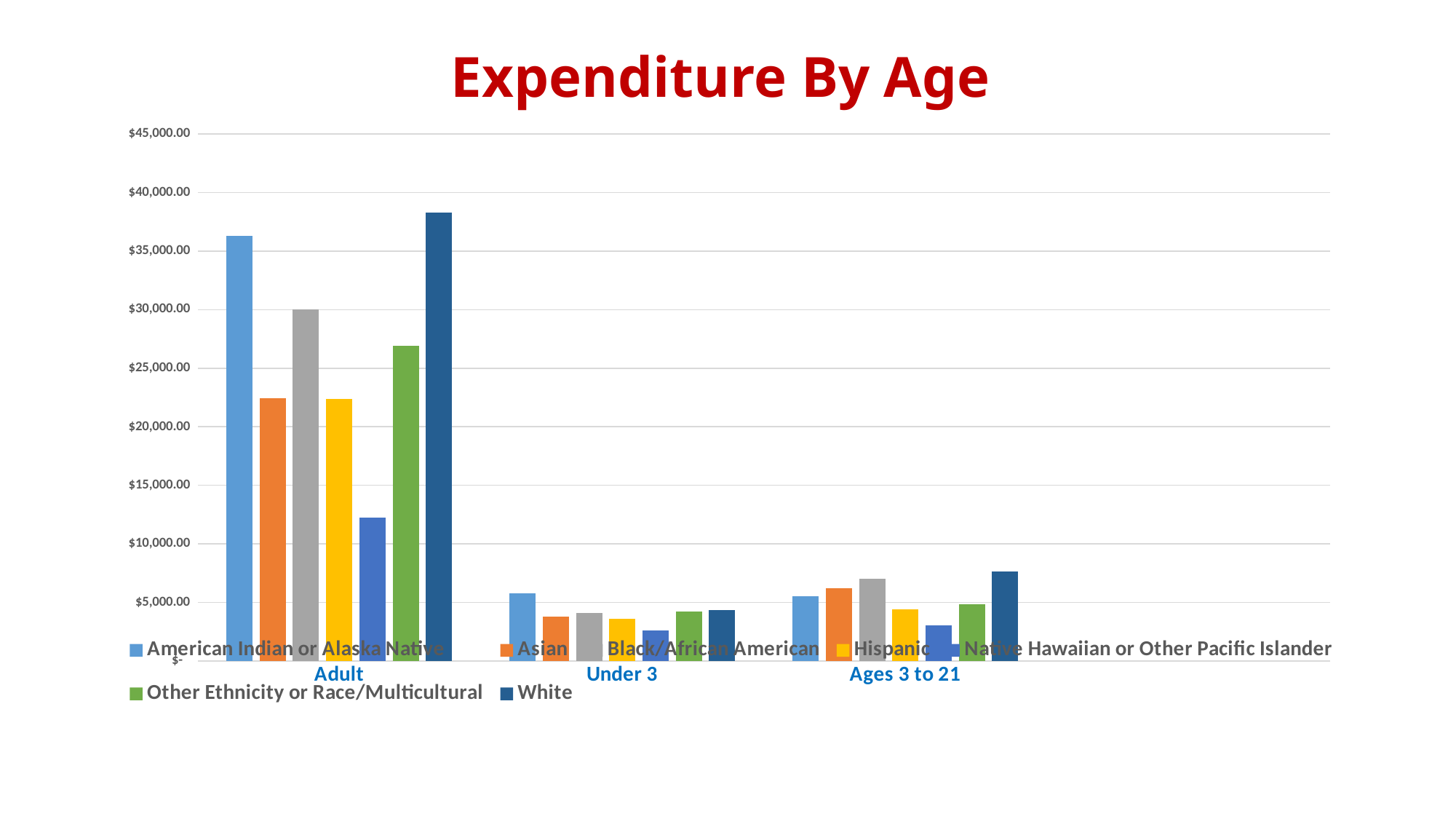
How many age categories are shown on the x axis? 3 In the Adult category, which is larger: the White bar or the American Indian or Alaska Native bar? White What is the title of the chart? Expenditure By Age In the Adult category, which series has the lowest expenditure? Native Hawaiian or Other Pacific Islander Is the Adult value for Other Ethnicity or Race/Multicultural greater or less than $25,000.00? greater Is the Adult value for Native Hawaiian or Other Pacific Islander greater or less than $15,000.00? less Is the Adult value for American Indian or Alaska Native greater or less than $35,000.00? greater In the Ages 3 to 21 category, which series has the highest expenditure? White In the Under 3 category, which series has the highest expenditure? American Indian or Alaska Native How many series does the legend list? 7 In the Adult category, which series has the highest expenditure? White What kind of chart is shown on the slide? bar chart